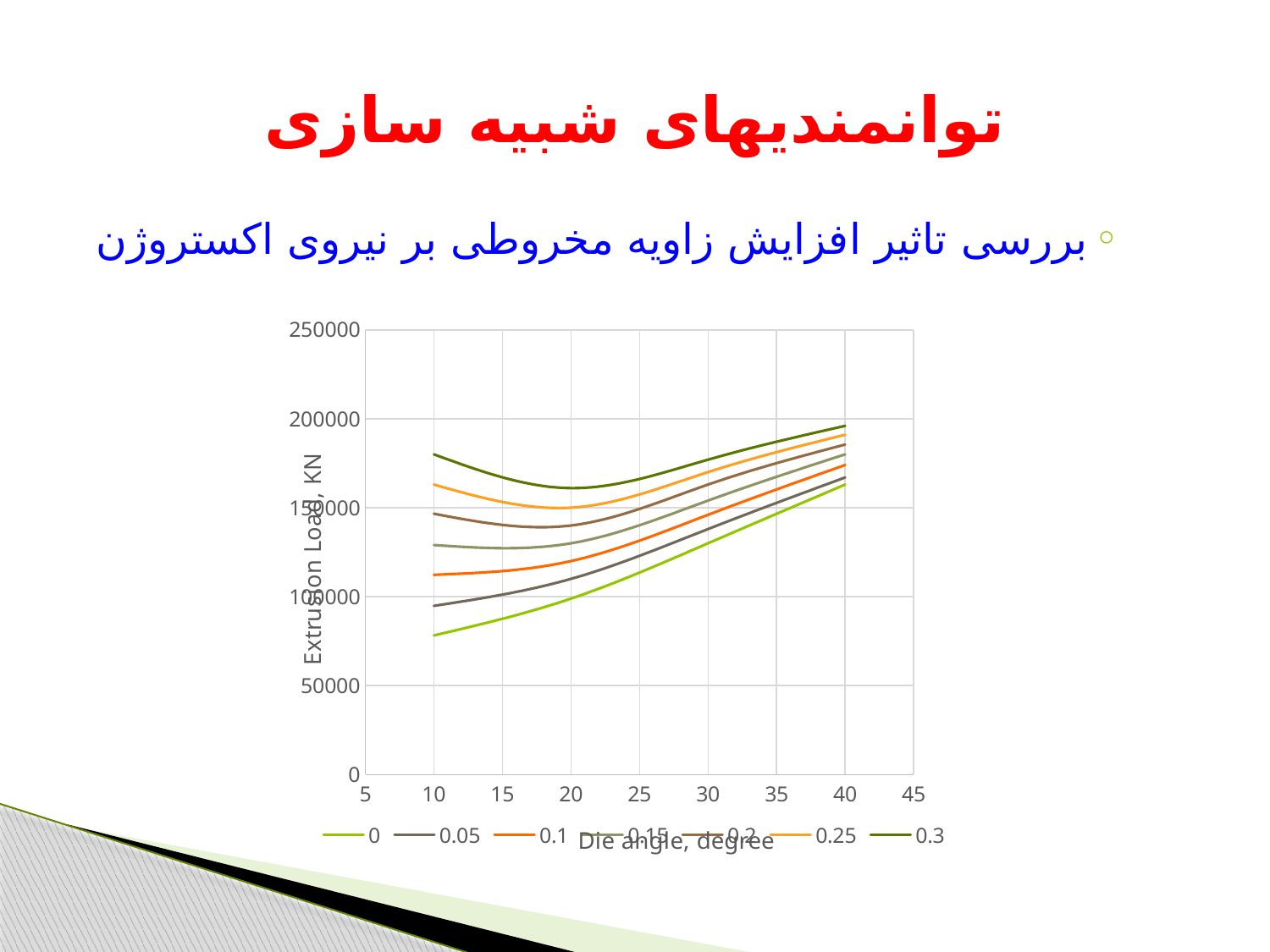
Which series has the highest extrusion load at a die angle of 40 degrees? 0.3 At a die angle of 10 degrees, which series has the larger extrusion load, 0.3 or 0? 0.3 Is the extrusion load for series 0.1 at a die angle of 10 degrees greater or less than 100000? greater Is the extrusion load for series 0.3 at a die angle of 10 degrees greater or less than 150000? greater Is the extrusion load for series 0.15 at a die angle of 10 degrees greater or less than 150000? less Which series has the lowest extrusion load at a die angle of 10 degrees? 0 What is the title of the horizontal axis? Die angle, degree How many series does the legend list? 7 Does the extrusion load for series 0 rise or fall as the die angle increases from 10 to 40 degrees? rise What is the title of the vertical axis? Extrusion Load, KN What kind of chart is shown on the slide? line chart